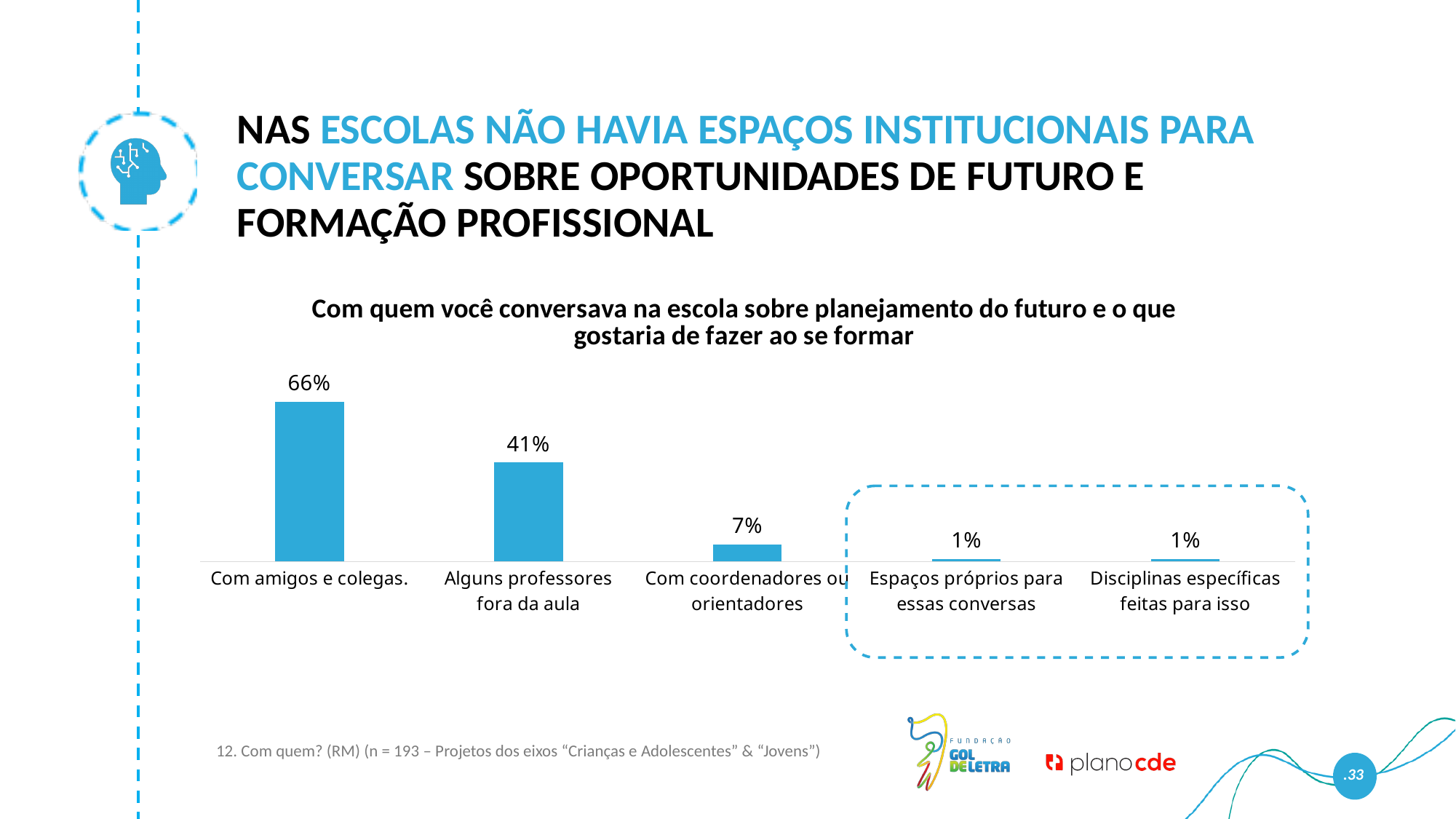
What is the value for "Alguns professores fora da aula"? 41% Do the values rise or fall from left to right across the categories? Fall What is the title of the chart? Com quem você conversava na escola sobre planejamento do futuro e o que gostaria de fazer ao se formar Which category has the highest value? Com amigos e colegas. What kind of chart is shown on the slide? Bar chart What is the value for "Espaços próprios para essas conversas"? 1% What is the difference between the values for "Com amigos e colegas." and "Alguns professores fora da aula"? 25% How many categories are shown in the chart? 5 What is the value for "Com coordenadores ou orientadores"? 7% What is the difference between the values for "Alguns professores fora da aula" and "Com coordenadores ou orientadores"? 34% Which is larger, the value for "Com coordenadores ou orientadores" or the value for "Disciplinas específicas feitas para isso"? Com coordenadores ou orientadores What is the value for "Com amigos e colegas."? 66%